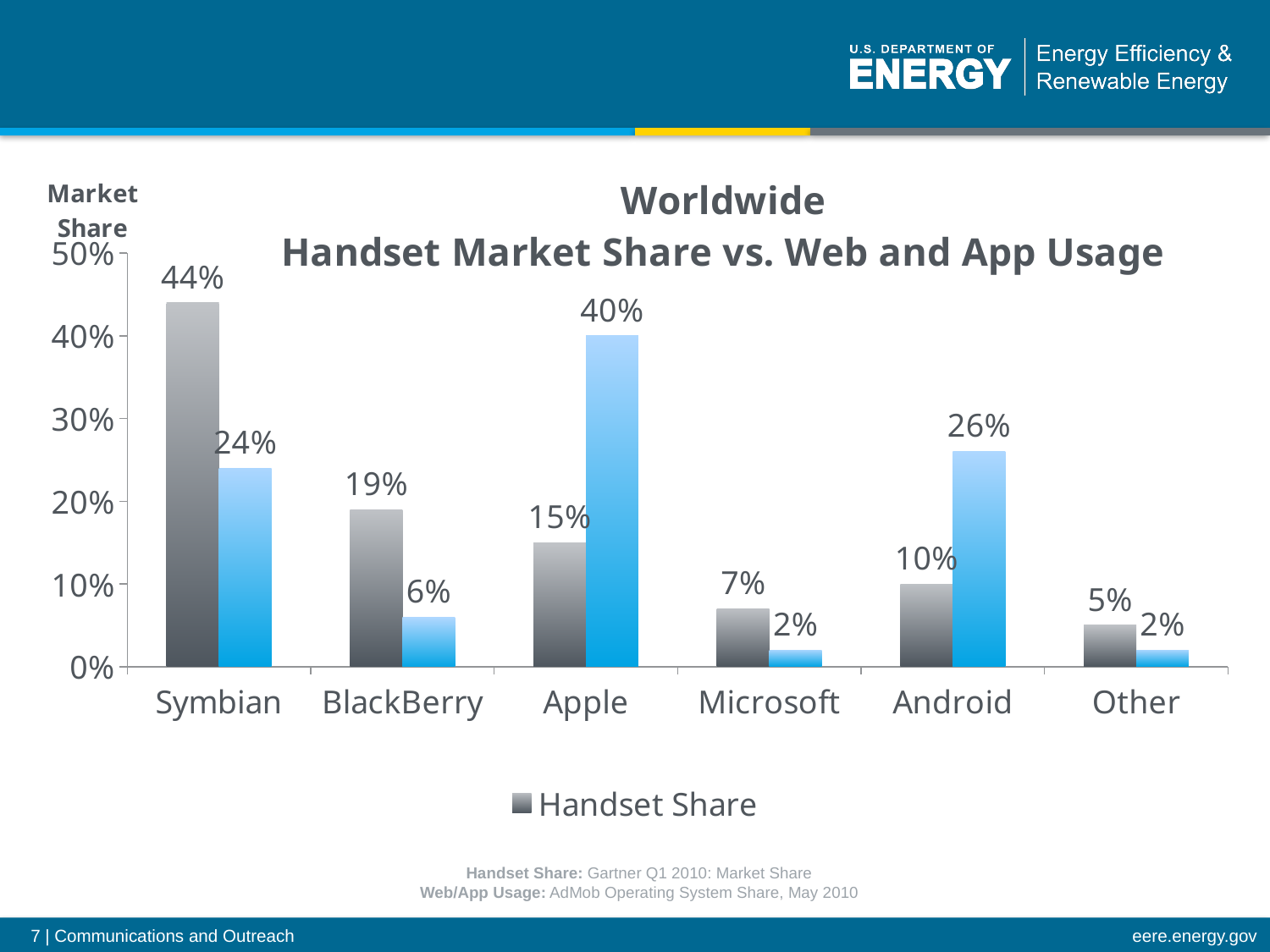
What is the Handset Share value for Android? 10% Which category has the lowest Handset Share? Other What is the value of the blue (Web and App Usage) bar for BlackBerry? 6% How many categories are shown on the x axis? 6 What is the difference between the Handset Share and the blue (Web and App Usage) bar for Symbian? 20% Which category has the highest Handset Share? Symbian What is the Handset Share value for Symbian? 44% How many entries does the legend list? 1 What is the value of the blue (Web and App Usage) bar for Apple? 40% Which is larger for Android: the Handset Share bar or the blue (Web and App Usage) bar? The blue (Web and App Usage) bar Which category has the highest blue (Web and App Usage) bar? Apple What type of chart is shown on the slide? Bar chart